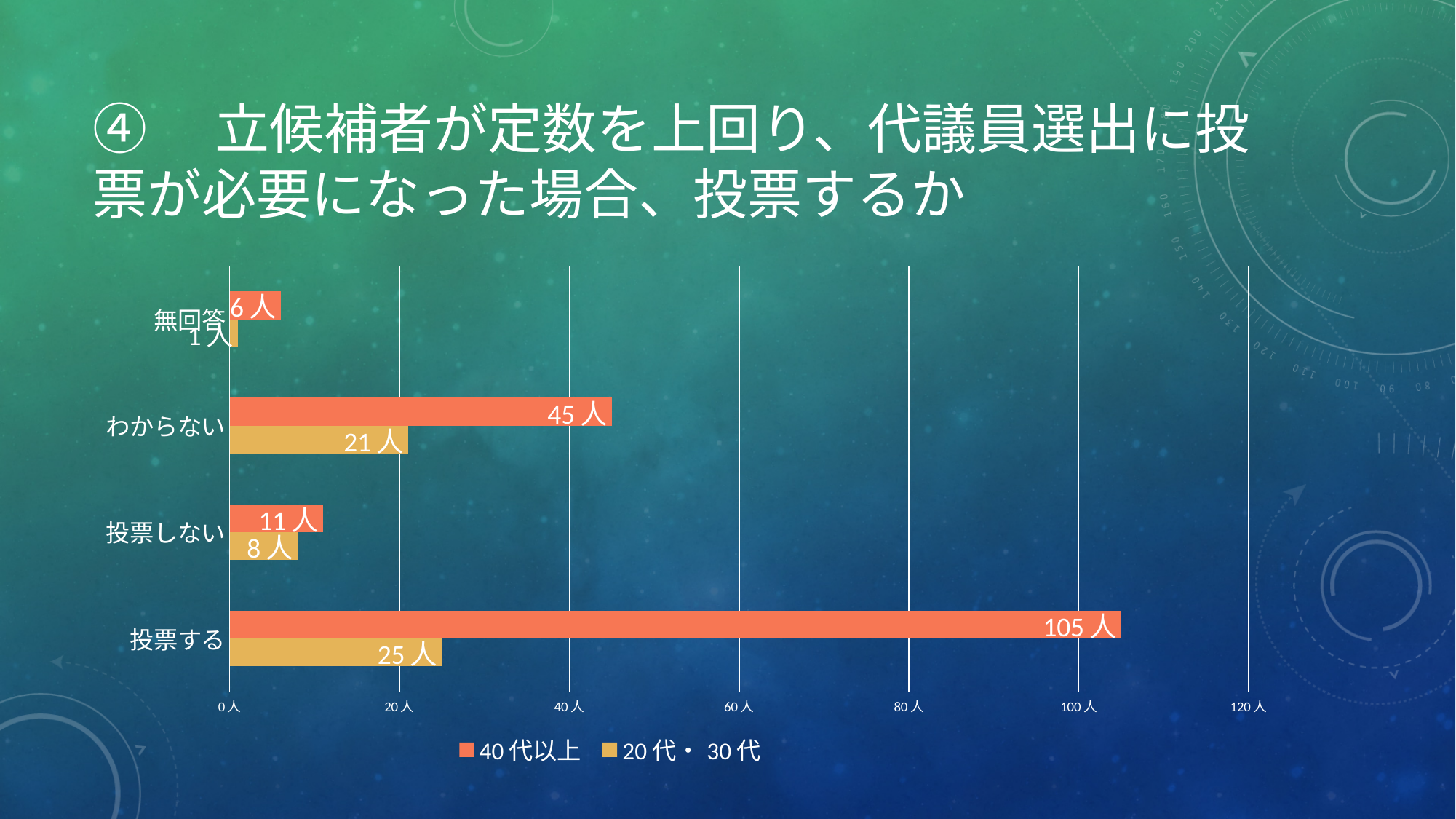
Which series is shown in orange in the legend? 40代以上 Which is larger in the 投票しない category: 40代以上 or 20代・30代? 40代以上 What is the value for 40代以上 in the わからない category? 45人 What is the value for 20代・30代 in the 投票する category? 25人 Which category has the lowest value for 20代・30代? 無回答 What is the value for 20代・30代 in the 投票しない category? 8人 What is the difference between the 40代以上 and 20代・30代 values in the わからない category? 24人 How many series does the legend list? 2 How many categories are shown on the chart? 4 What is the value for 40代以上 in the 投票する category? 105人 What kind of chart is shown on the slide? bar chart Which category has the highest value for 40代以上? 投票する